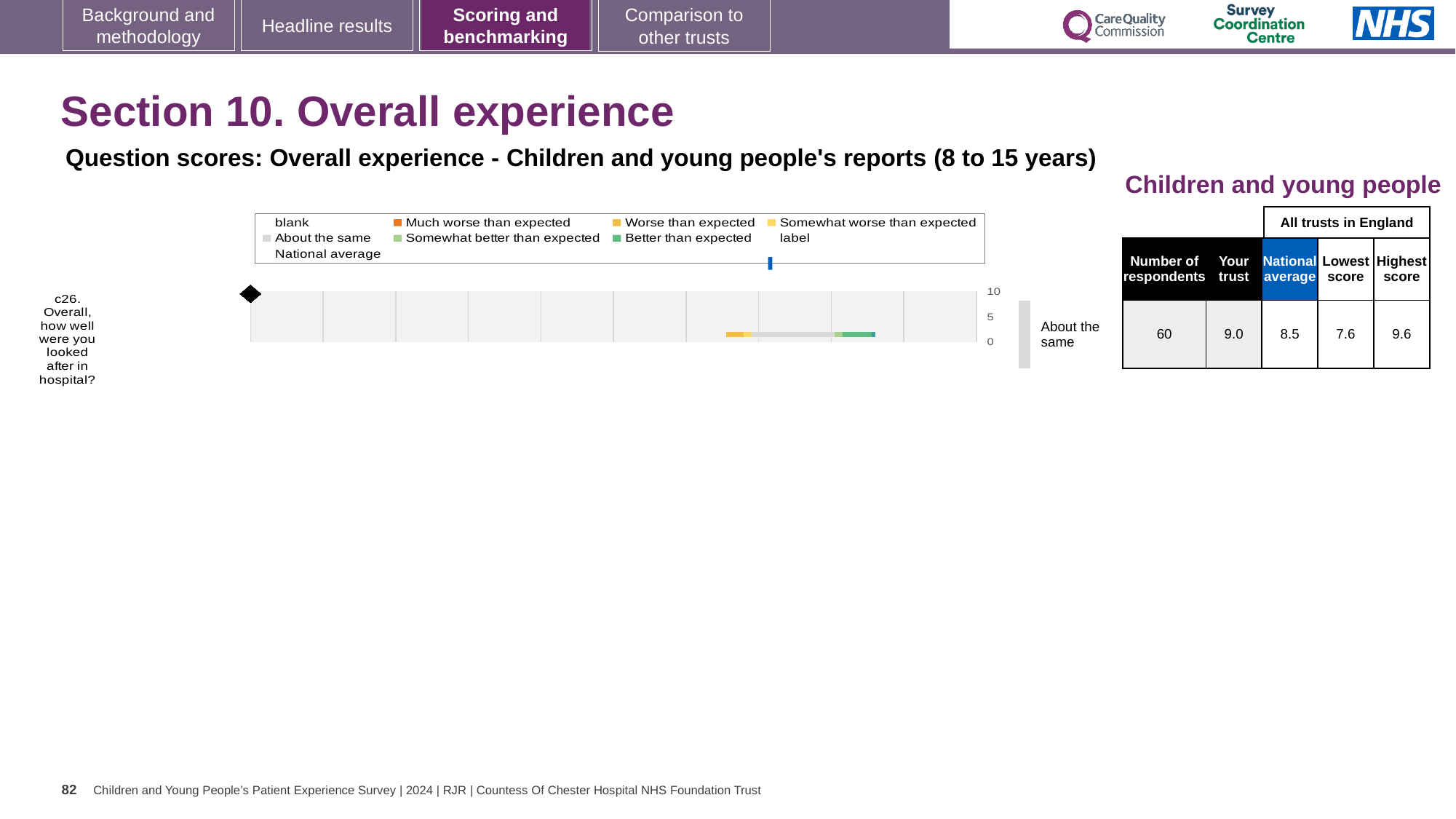
What is the difference between the 'Your trust' score and the national average for question c26? 0.5 How many survey questions (categories) are plotted in the chart? 1 Which is larger for question c26: the 'Your trust' score or the national average? Your trust What is the score for 'Your trust' on question c26? 9.0 Which survey question is plotted in the chart? c26. Overall, how well were you looked after in hospital? What is the highest score among all trusts in England for question c26? 9.6 What is the difference between the highest and lowest scores among all trusts in England for question c26? 2.0 Which benchmark category is the trust's result for question c26 placed in? About the same What is the national average score for question c26? 8.5 What is the lowest score among all trusts in England for question c26? 7.6 How many respondents answered question c26? 60 What kind of chart is shown on the slide? bar chart